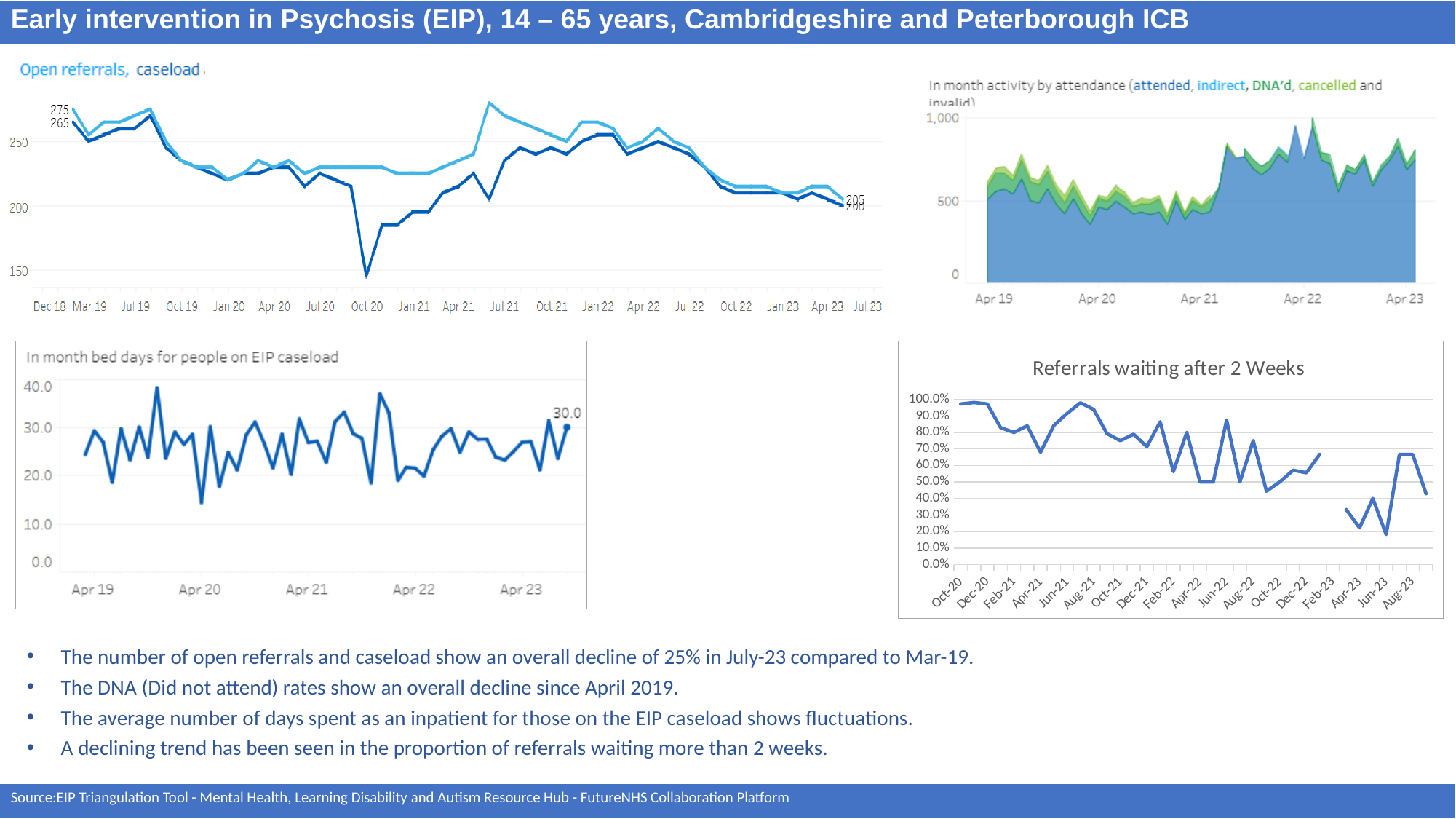
On the 'Open referrals, caseload' chart, what is the labelled value of open referrals at the start of the series (Dec 18)? 275 On the 'Open referrals, caseload' chart, what is the labelled value of open referrals at the end of the series? 205 How many series does the 'Open referrals, caseload' chart show? 2 On the 'In month bed days for people on EIP caseload' chart, is the highest value greater or less than 30.0? greater On the 'Open referrals, caseload' chart, what is the difference between the labelled open referrals and caseload values at the start of the series? 10 On the 'Referrals waiting after 2 Weeks' chart, do the values overall rise or fall from Oct-20 to Aug-23? Fall On the 'In month bed days for people on EIP caseload' chart, what is the labelled value of the last data point? 30.0 What kind of chart is 'In month activity by attendance'? Area chart On the 'Referrals waiting after 2 Weeks' chart, is the lowest value greater or less than 30.0%? less On the 'Open referrals, caseload' chart, what is the labelled value of caseload at the start of the series (Dec 18)? 265 On the 'Open referrals, caseload' chart, which is larger at the start of the series: open referrals or caseload? Open referrals What kind of chart is 'Referrals waiting after 2 Weeks'? Line chart